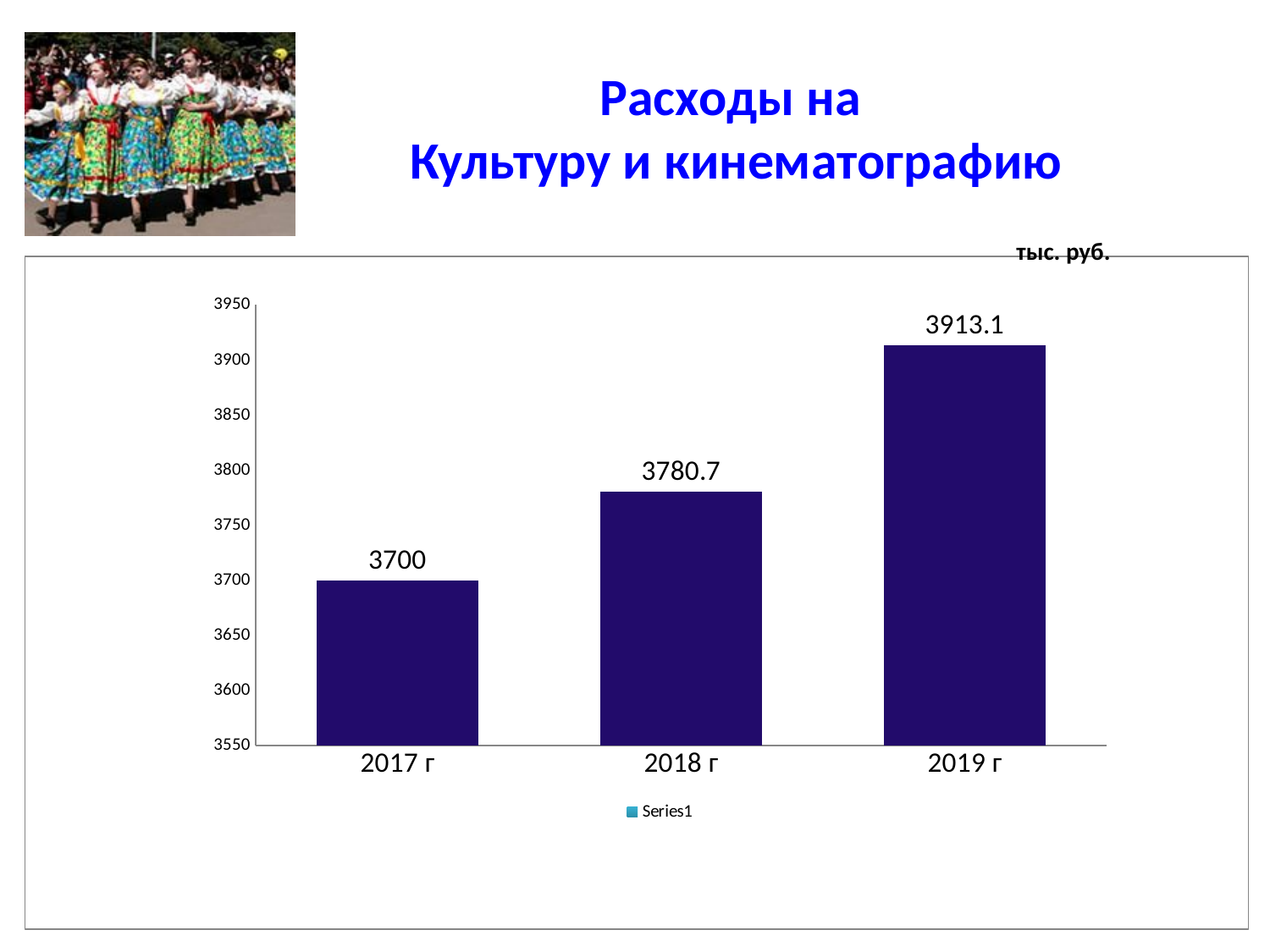
What is the difference between the values for 2018 г and 2017 г? 80.7 What is the value for 2017 г? 3700 Which is larger, the value for 2017 г or the value for 2018 г? 2018 г Which year has the highest value? 2019 г Is the value for 2019 г greater or less than 3900? greater What kind of chart is shown on the slide? bar chart What is the value for 2019 г? 3913.1 How many years are shown on the chart? 3 Do the values rise or fall from 2017 г to 2019 г? rise What is the value for 2018 г? 3780.7 What is the difference between the values for 2019 г and 2018 г? 132.4 Which year has the lowest value? 2017 г